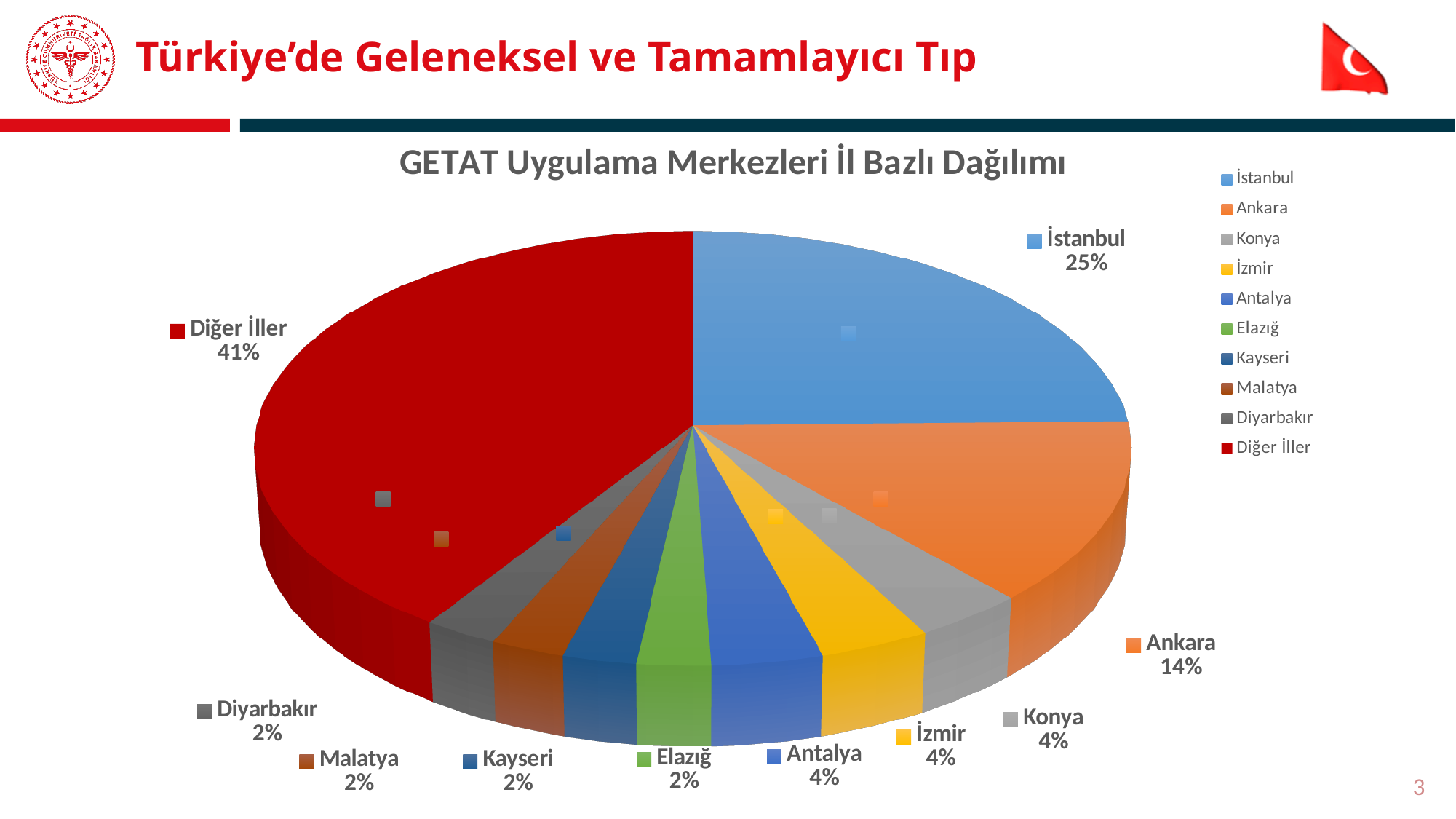
What share of the pie does Konya have? 4% What is the title of the chart? GETAT Uygulama Merkezleri İl Bazlı Dağılımı What share of the pie does Diğer İller have? 41% Which category has the largest slice of the pie? Diğer İller What share of the pie does Malatya have? 2% What is the difference in percentage points between İstanbul and Ankara? 11 What share of the pie does İstanbul have? 25% How many categories does the legend list? 10 What colour is the Diğer İller slice? Red Which is larger, the share for İzmir or the share for Elazığ? İzmir What kind of chart is shown on the slide? Pie chart What share of the pie does Ankara have? 14%